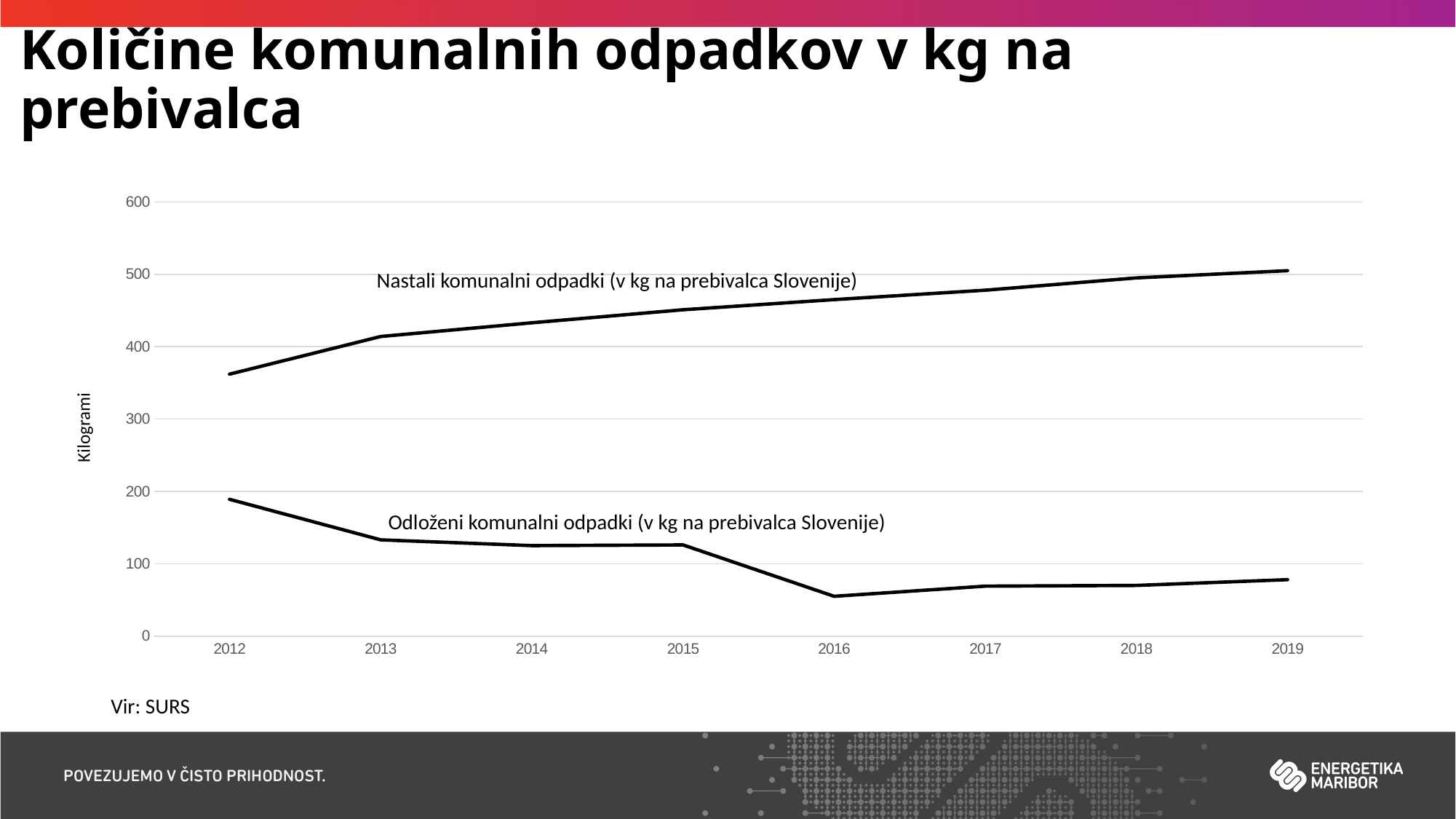
Does the series 'Nastali komunalni odpadki' rise or fall from 2012 to 2019? rise Which is larger for 'Odloženi komunalni odpadki': the value in 2012 or the value in 2013? 2012 What kind of chart is shown on the slide? line chart In which year is the series 'Nastali komunalni odpadki' highest? 2019 Is the value for 'Odloženi komunalni odpadki' in 2016 greater or less than 100? less In which year is the series 'Odloženi komunalni odpadki' lowest? 2016 What is the label on the vertical axis of the chart? Kilogrami In which year is the series 'Nastali komunalni odpadki' lowest? 2012 How many data series are plotted on the chart? 2 How many years are plotted along the x axis? 8 Is the value for 'Nastali komunalni odpadki' in 2012 greater or less than 400? less In which year is the series 'Odloženi komunalni odpadki' highest? 2012